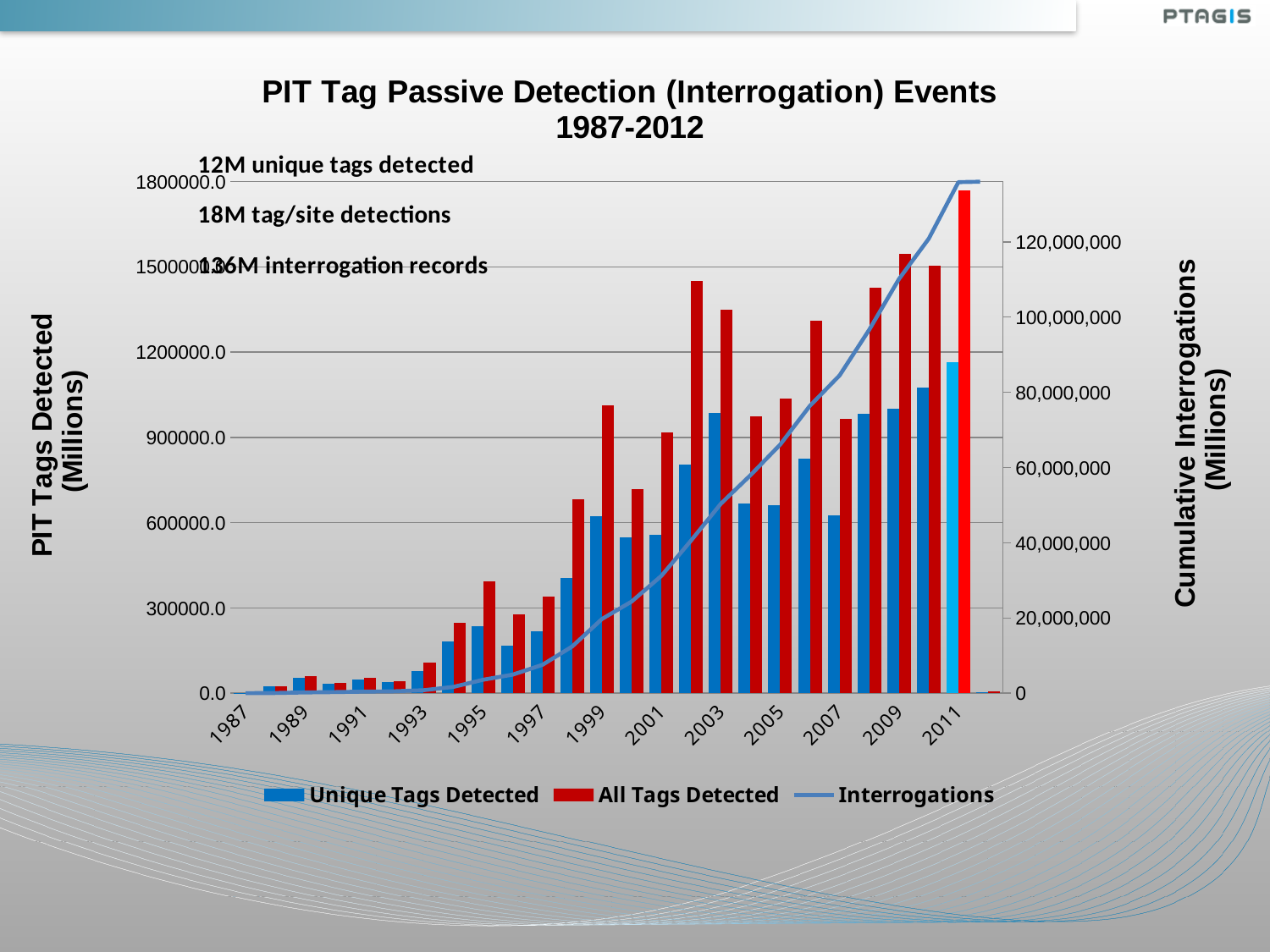
Is the All Tags Detected value for 2003 greater or less than 1200000.0? greater Which series is plotted as a line rather than bars? Interrogations What is the title of the chart? PIT Tag Passive Detection (Interrogation) Events 1987-2012 Which is larger in 2003: Unique Tags Detected or All Tags Detected? All Tags Detected What kind of chart is shown on the slide? A combined bar and line chart Is the Interrogations value for 2011 greater or less than 120,000,000? greater Does the Interrogations line rise or fall from 1987 to 2011? Rises Which year has the larger All Tags Detected value: 2003 or 2005? 2003 Is the All Tags Detected value for 1999 greater or less than 900000.0? greater How many series does the legend list? 3